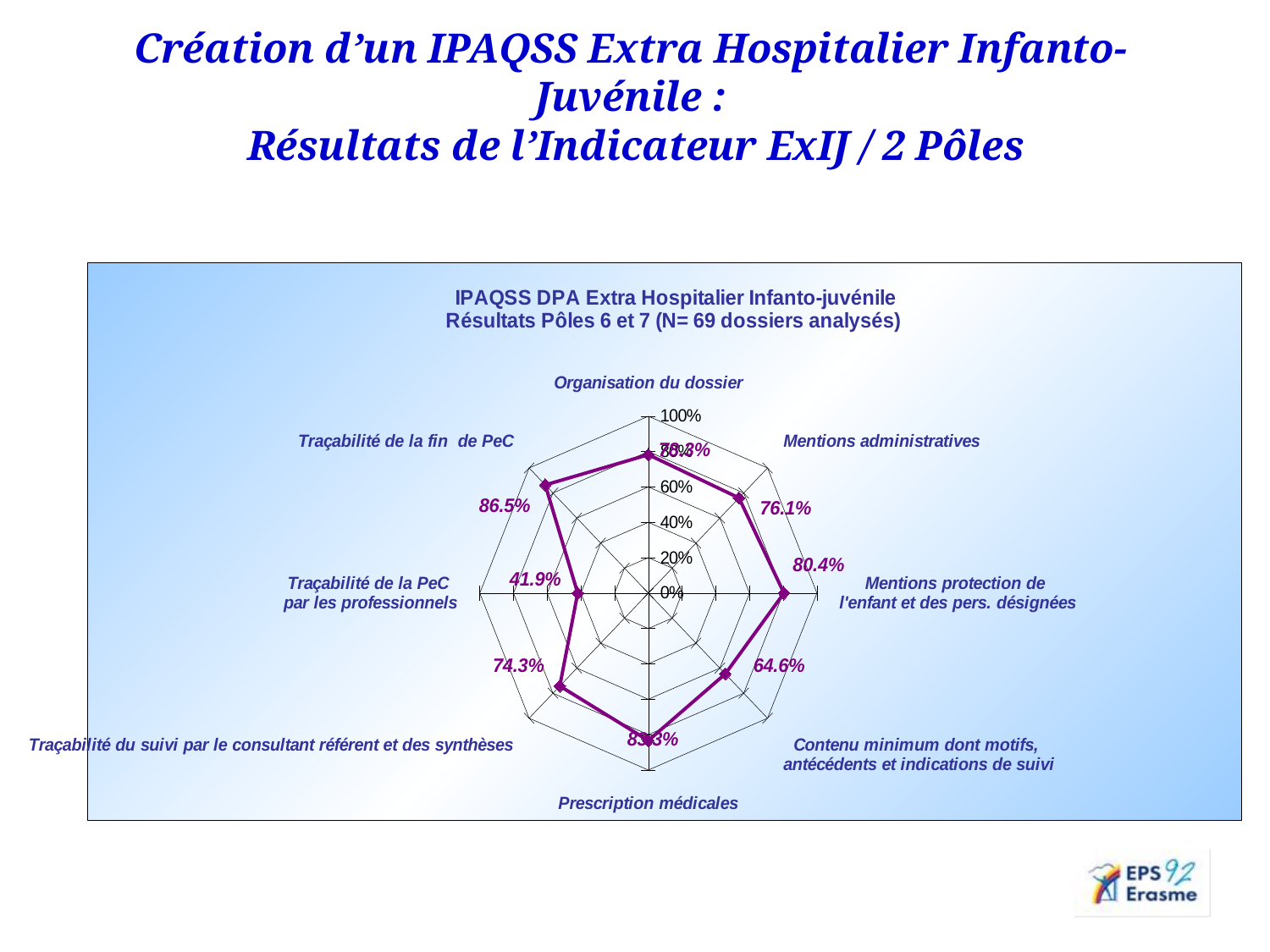
How many categories (axes) does the radar chart have? 8 What is the value for Mentions protection de l'enfant et des pers. désignées? 80.4% What kind of chart is shown on the slide? Radar chart What is the value for Contenu minimum dont motifs, antécédents et indications de suivi? 64.6% According to the chart title, how many dossiers were analysed? 69 What is the difference between the values for Mentions protection de l'enfant et des pers. désignées and Mentions administratives? 4.3 percentage points Which category has the lowest value? Traçabilité de la PeC par les professionnels What is the value for Mentions administratives? 76.1% What is the value for Traçabilité de la PeC par les professionnels? 41.9% What is the value for Traçabilité de la fin de PeC? 86.5% Is the value for Organisation du dossier greater or less than 60%? greater Which is larger: the value for Traçabilité du suivi par le consultant référent et des synthèses or the value for Contenu minimum dont motifs, antécédents et indications de suivi? Traçabilité du suivi par le consultant référent et des synthèses